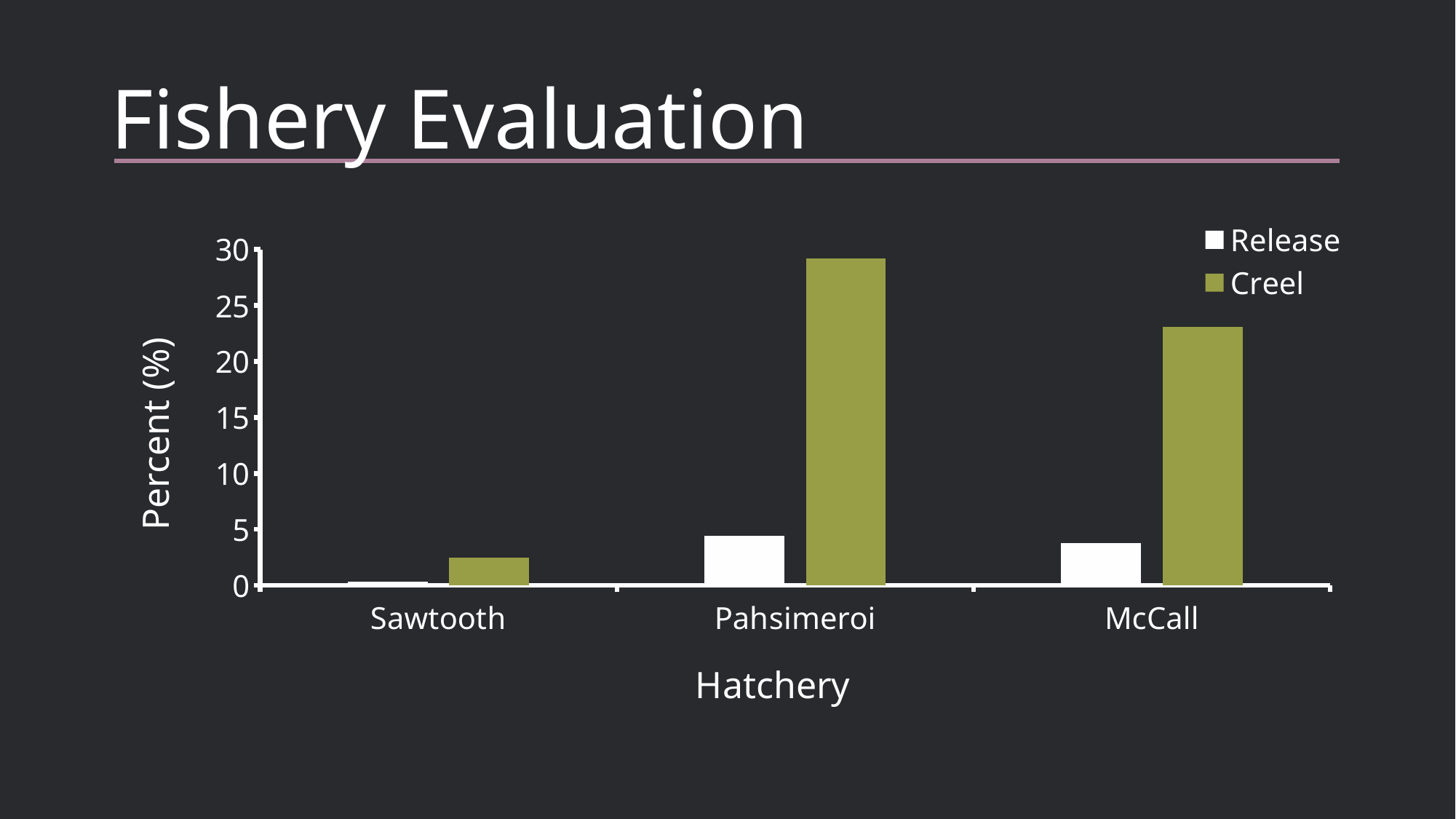
Which hatchery has the lowest Creel value? Sawtooth How many hatcheries are shown on the x axis? 3 What kind of chart is shown on the slide? bar chart Is the Release value for Pahsimeroi greater or less than 5? less How many series does the legend list? 2 Is the Creel value for Pahsimeroi greater or less than 25? greater What is the label on the y axis? Percent (%) Is the Creel value for McCall greater or less than 20? greater Which hatchery has the lowest Release value? Sawtooth For McCall, which is larger, the Release value or the Creel value? Creel Which hatchery has the highest Creel value? Pahsimeroi